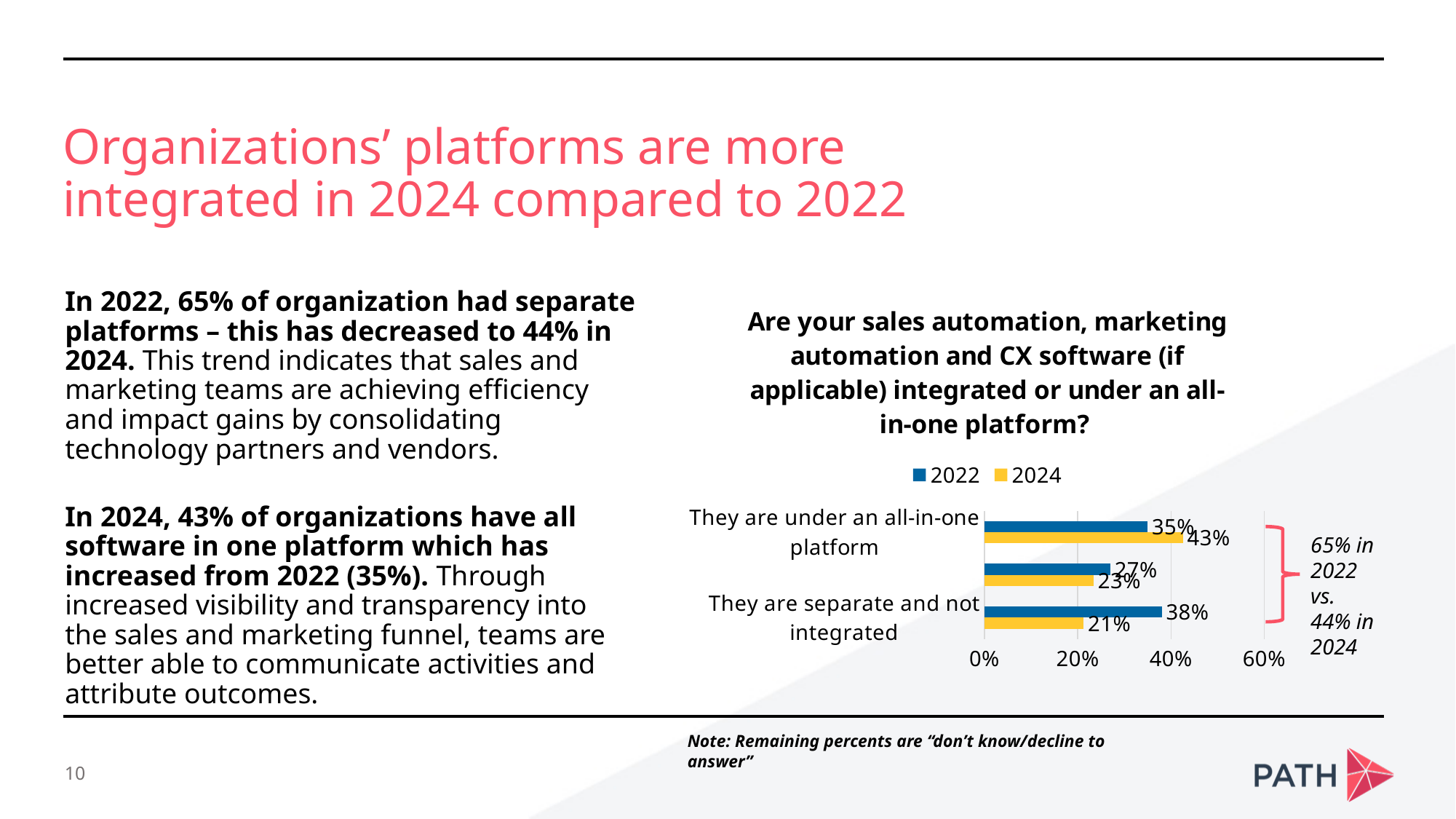
What is the 2022 value for 'They are under an all-in-one platform'? 35% What type of chart is shown on the slide? Bar chart By how many percentage points did 'They are separate and not integrated' change from 2022 to 2024? 17 percentage points Which year has the larger value for 'They are under an all-in-one platform', 2022 or 2024? 2024 Which year has the larger value for 'They are separate and not integrated', 2022 or 2024? 2022 How many series does the chart legend list? 2 Is the 2024 value for 'They are under an all-in-one platform' greater or less than 40%? greater What is the 2024 value for 'They are under an all-in-one platform'? 43% What is the 2024 value for 'They are separate and not integrated'? 21% By how many percentage points did 'They are under an all-in-one platform' increase from 2022 to 2024? 8 percentage points Which colour represents the 2024 series in the chart? Yellow What is the 2022 value for 'They are separate and not integrated'? 38%